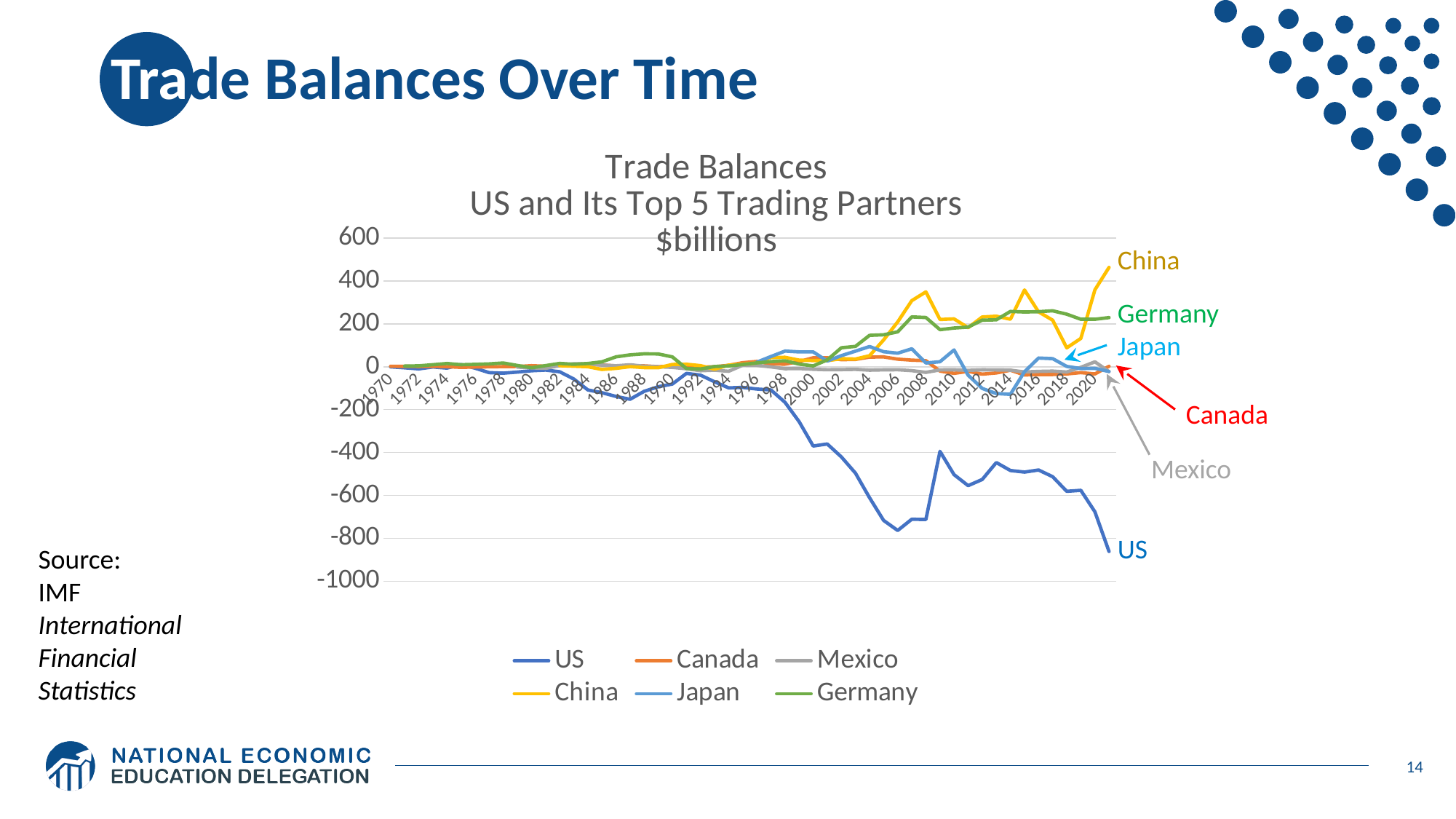
Is the value for Germany in 2020 greater or less than 200? greater Is the value for the US in 2006 greater or less than -600? less What unit is stated in the chart title? $billions What is the source of the data shown in the chart? IMF International Financial Statistics Is the value for the US in 2020 greater or less than -800? greater In 2020, which is larger, the value for China or the value for Germany? China What kind of chart is shown on the slide? Line chart Which series has the highest value in 2020? China How many series does the legend list? 6 Which series has the lowest value in 2020? US Does the US line generally rise or fall from 1970 to 2020? Fall